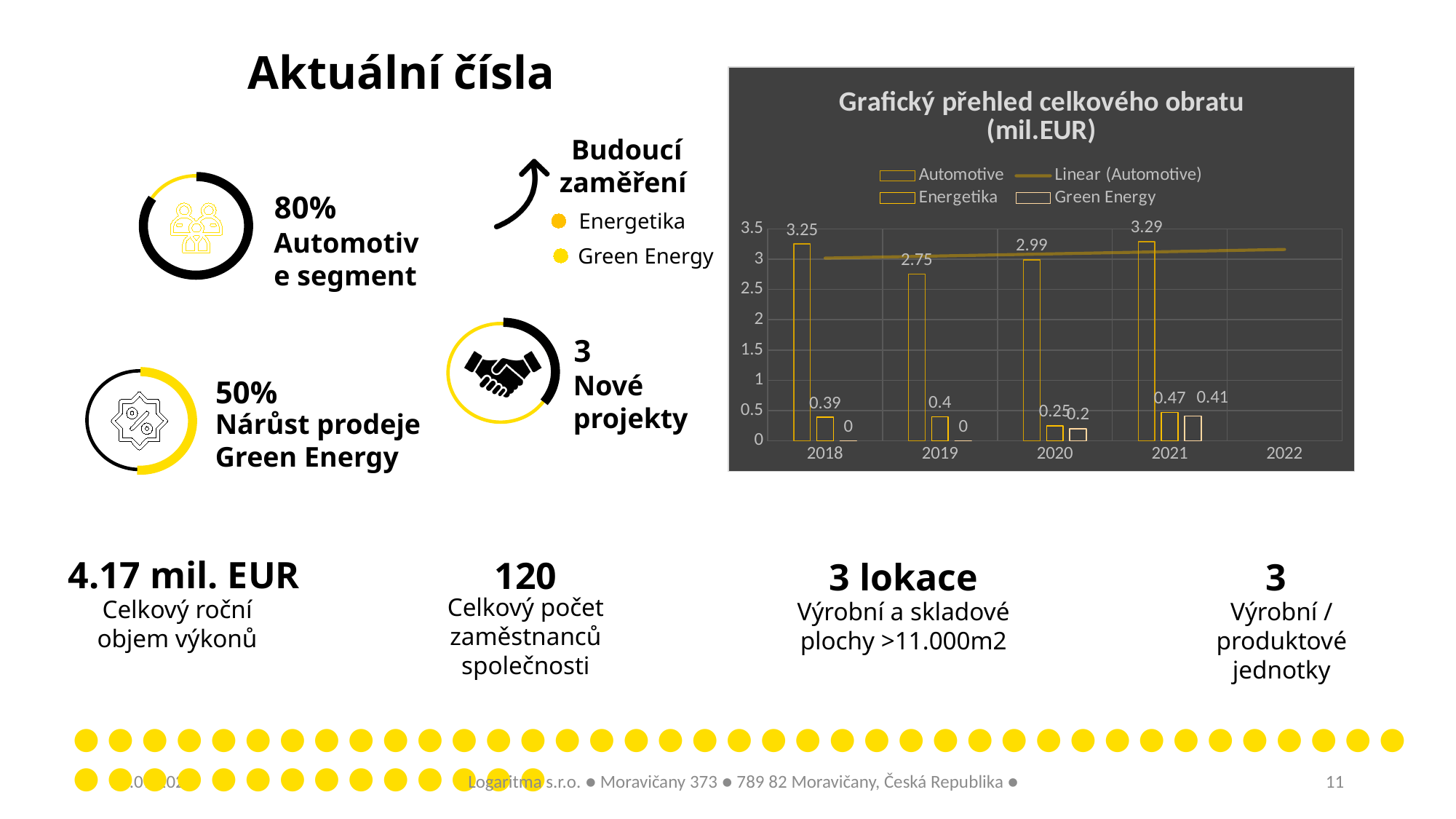
What is the Green Energy value for 2020? 0.2 How many entries does the legend list? 4 In which year is the Automotive value the highest? 2021 How many years are shown on the x axis? 5 What is the Automotive value for 2018? 3.25 In which year is the Automotive value the lowest? 2019 What is the difference between the Automotive values for 2021 and 2019? 0.54 Which is larger in 2021, the Energetika value or the Green Energy value? Energetika What is the Energetika value for 2021? 0.47 What kind of chart is shown? bar chart Is the Automotive value for 2019 greater or less than 3? less What is the title of the chart? Grafický přehled celkového obratu (mil.EUR)